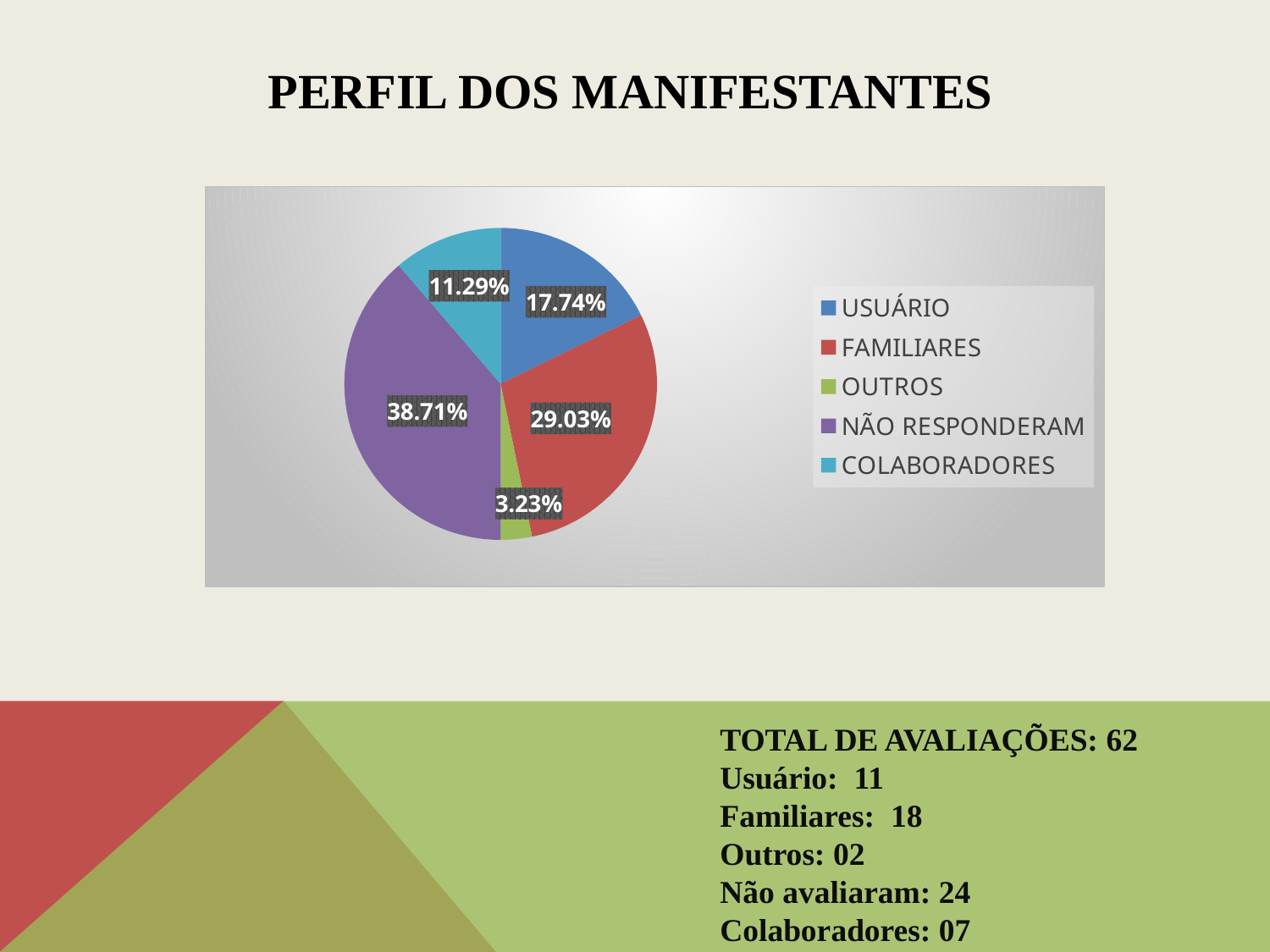
What is the difference in percentage points between the NÃO RESPONDERAM slice and the FAMILIARES slice? 9.68 What share of the pie does USUÁRIO represent? 17.74% What share of the pie does COLABORADORES represent? 11.29% What share of the pie does NÃO RESPONDERAM represent? 38.71% What kind of chart is shown on the slide? pie chart What share of the pie does FAMILIARES represent? 29.03% What is the title of the slide containing the pie chart? PERFIL DOS MANIFESTANTES Which category has the smallest slice of the pie? OUTROS How many categories does the legend of the pie chart list? 5 Which category has the largest slice of the pie? NÃO RESPONDERAM What share of the pie does OUTROS represent? 3.23% Which is larger, the slice for FAMILIARES or the slice for USUÁRIO? FAMILIARES